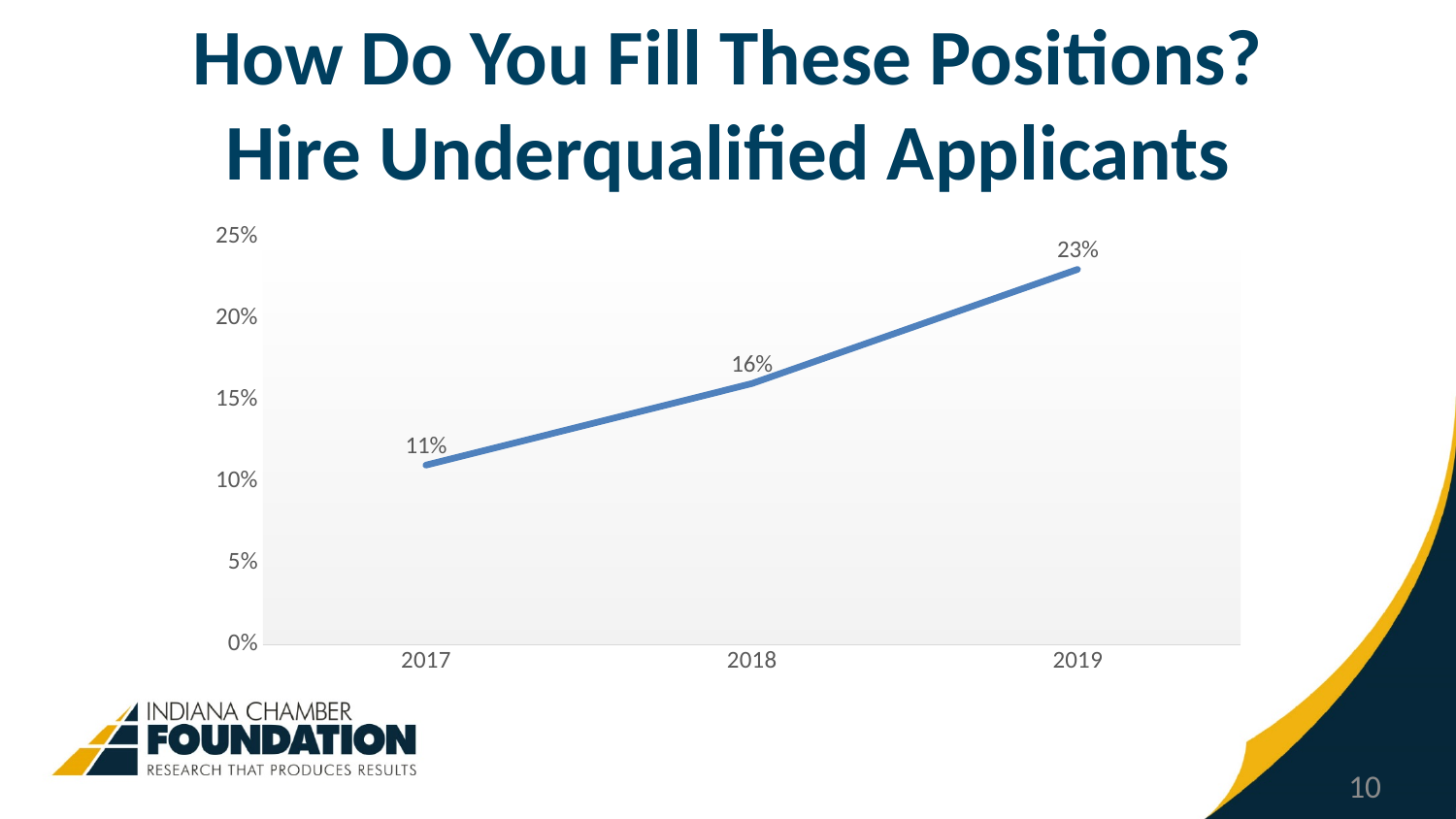
What kind of chart is shown on the slide? line chart What is the value for 2018? 16% Which year has the lowest value? 2017 Do the values rise or fall from 2017 to 2019? rise Which is larger, the value for 2018 or the value for 2019? 2019 What is the difference between the values for 2019 and 2017? 12% Is the value for 2019 greater or less than 20%? greater What is the difference between the values for 2018 and 2017? 5% What is the value for 2019? 23% What is the value for 2017? 11% How many years are plotted on the chart? 3 Which year has the highest value? 2019